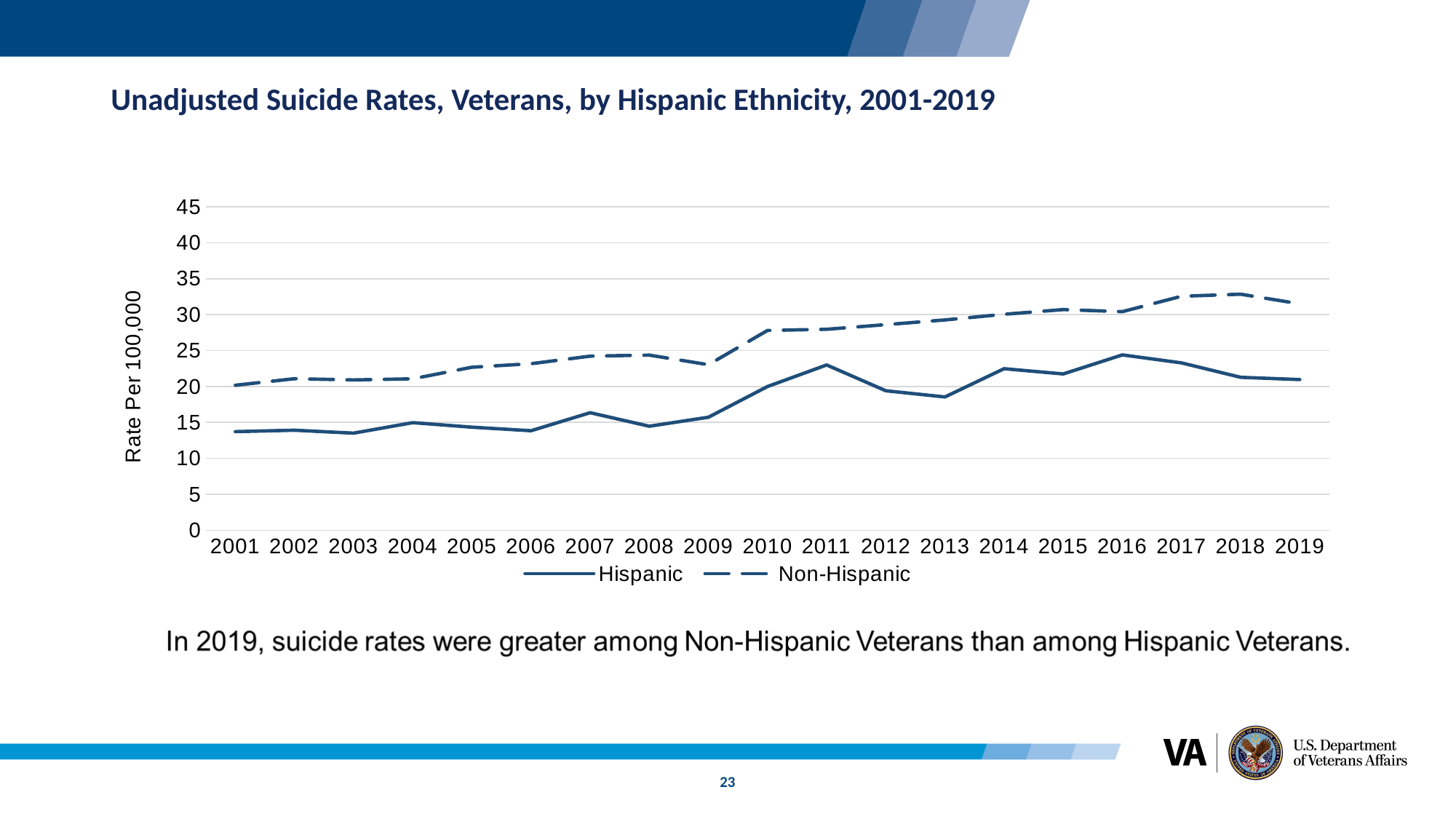
In 2019, which series has the higher value, Hispanic or Non-Hispanic? Non-Hispanic What is the label on the y axis? Rate Per 100,000 Is the value for Non-Hispanic in 2010 greater or less than 25? greater Does the Non-Hispanic series generally rise or fall from 2001 to 2019? Rise How many years are plotted along the x axis? 19 What kind of chart is shown on the slide? Line chart Is the value for Hispanic in 2001 greater or less than 15? less For the Hispanic series, which year has the higher value, 2011 or 2013? 2011 Is the value for Hispanic in 2011 greater or less than 20? greater What is the title of the chart? Unadjusted Suicide Rates, Veterans, by Hispanic Ethnicity, 2001-2019 How many series does the legend list? 2